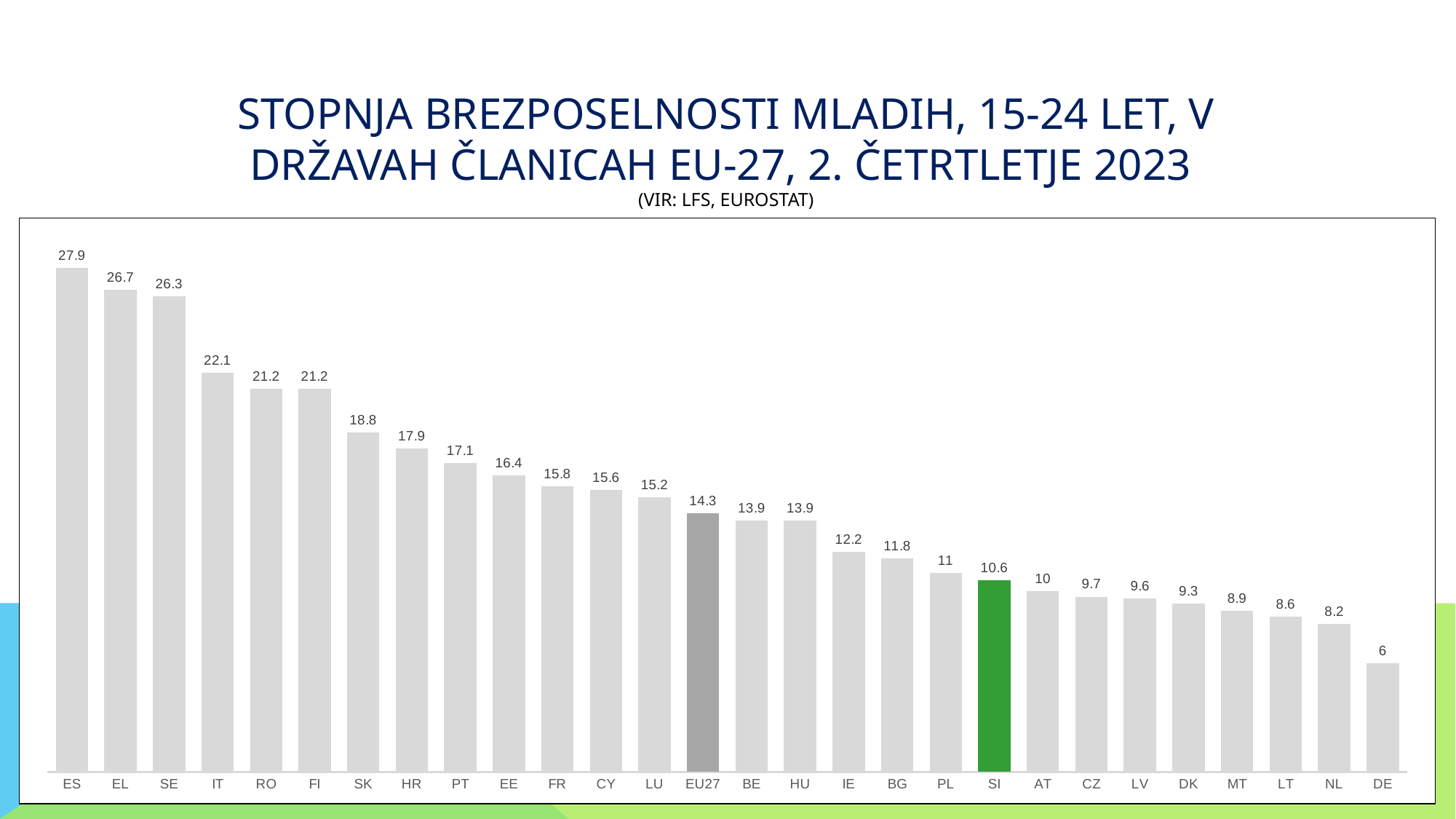
Which bar is coloured green? SI What is the value for SI? 10.6 Which category has the highest value? ES Which is larger, the value for IT or the value for SK? IT Do the values rise or fall from left to right along the x axis? Fall Which category has the lowest value? DE What kind of chart is shown on the slide? Bar chart What is the difference between the values for ES and DE? 21.9 How many bars are shown in the chart? 28 What is the value for DE? 6 What is the difference between the values for EU27 and SI? 3.7 What is the value for EU27? 14.3